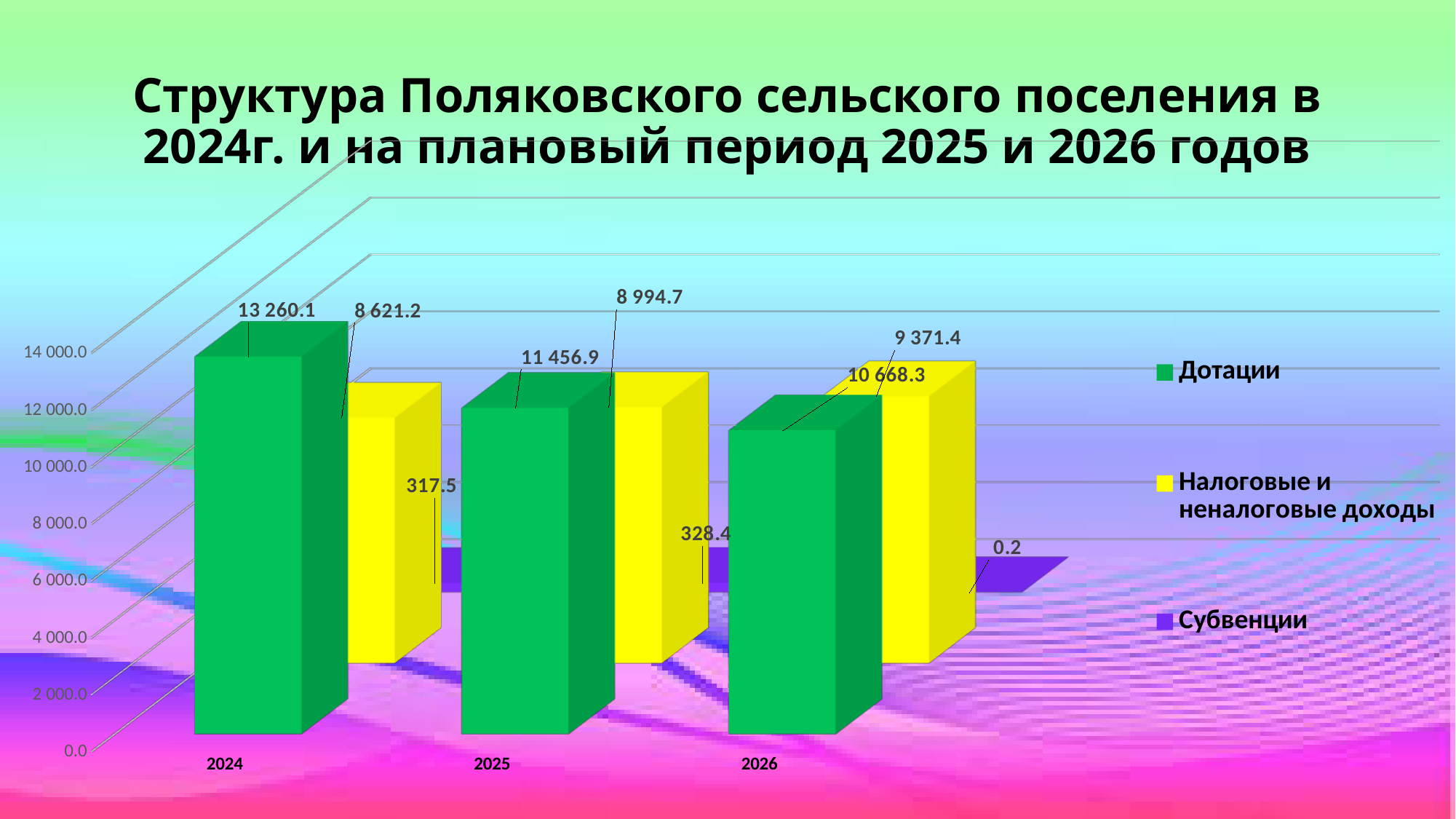
What kind of chart is shown on the slide? Bar chart What is the difference between Дотации in 2024 and Дотации in 2025? 1 803.2 In which year is Субвенции lowest? 2026 What is the value of Дотации for 2024? 13 260.1 How many years are shown on the x axis? 3 What is the value of Дотации for 2026? 10 668.3 What is the value of Налоговые и неналоговые доходы for 2026? 9 371.4 What is the value of Субвенции for 2025? 328.4 Which is larger in 2025: Дотации or Налоговые и неналоговые доходы? Дотации In which year is Дотации highest? 2024 How many series does the legend list? 3 Do the values for Налоговые и неналоговые доходы rise or fall from 2024 to 2026? Rise